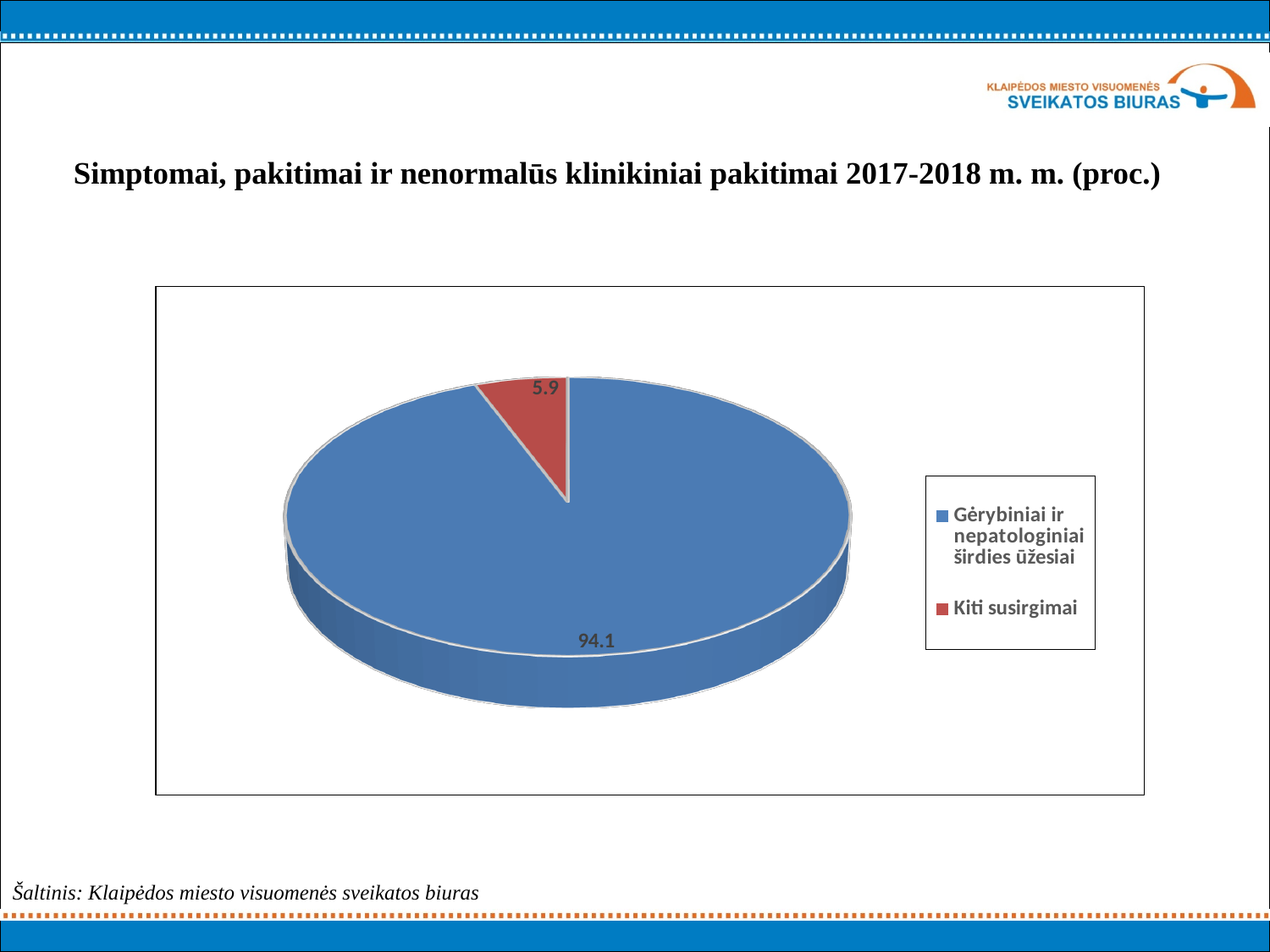
How many entries does the legend list? 2 What is the title of the slide containing the chart? Simptomai, pakitimai ir nenormalūs klinikiniai pakitimai 2017-2018 m. m. (proc.) What is the value for "Gėrybiniai ir nepatologiniai širdies ūžesiai"? 94.1 Which category has the smallest slice of the pie? Kiti susirgimai What is the total of the two slice values shown on the pie chart? 100 What colour is the slice for "Kiti susirgimai"? Red How many categories does the pie chart have? 2 What is the difference between the values for "Gėrybiniai ir nepatologiniai širdies ūžesiai" and "Kiti susirgimai"? 88.2 What kind of chart is shown on the slide? Pie chart Which is larger: the value for "Kiti susirgimai" or the value for "Gėrybiniai ir nepatologiniai širdies ūžesiai"? Gėrybiniai ir nepatologiniai širdies ūžesiai What is the value for "Kiti susirgimai"? 5.9 Which category has the largest slice of the pie? Gėrybiniai ir nepatologiniai širdies ūžesiai